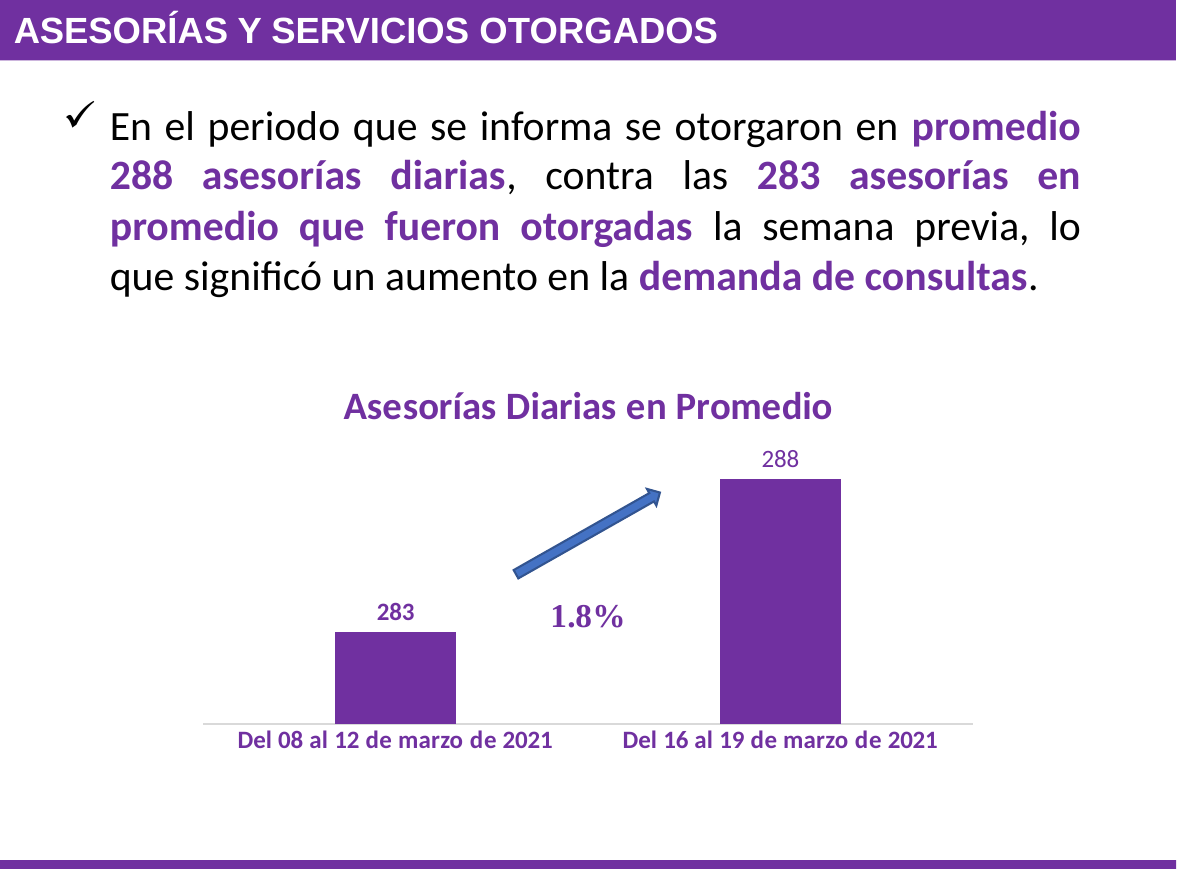
What percentage change is annotated between the two bars? 1.8% What kind of chart is shown on the slide? Bar chart What is the value for 'Del 16 al 19 de marzo de 2021'? 288 Which period has the lowest value? Del 08 al 12 de marzo de 2021 What is the difference between the values for 'Del 16 al 19 de marzo de 2021' and 'Del 08 al 12 de marzo de 2021'? 5 Which is larger: the value for 'Del 08 al 12 de marzo de 2021' or 'Del 16 al 19 de marzo de 2021'? Del 16 al 19 de marzo de 2021 What is the title of the chart? Asesorías Diarias en Promedio Which period has the highest value? Del 16 al 19 de marzo de 2021 What is the value for 'Del 08 al 12 de marzo de 2021'? 283 Do the values rise or fall from left to right along the x axis? Rise How many categories are shown in the chart? 2